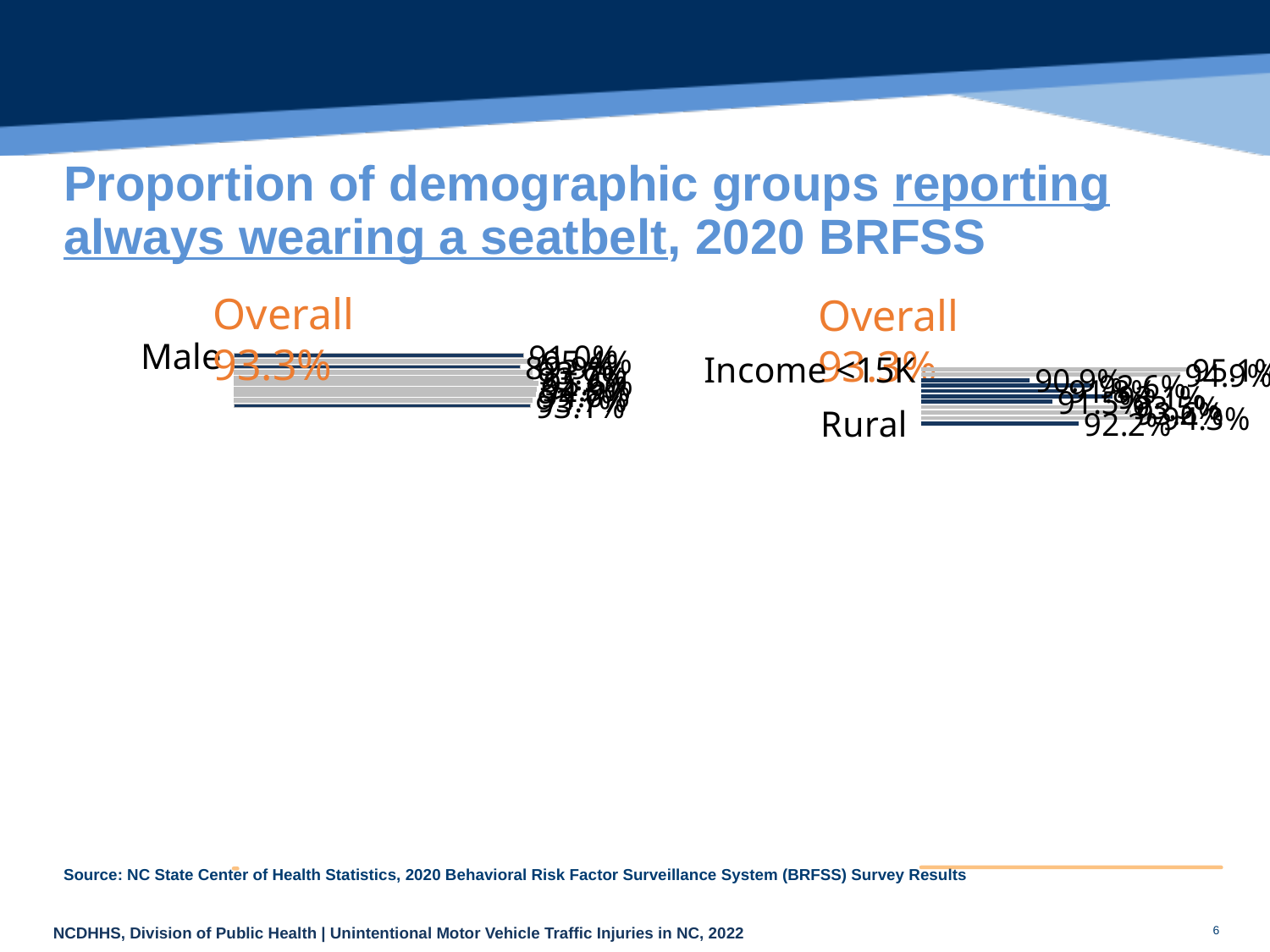
In the right chart, what is the value labelled for Rural? 92.2% What colour is the 'Overall' label text on the charts? orange In the right chart, which is larger, the Overall value or the Rural value? Overall In the right chart, what is the difference between the Overall value and the Rural value? 1.1% How many charts are shown on the slide? 2 What kind of chart is the right chart? bar chart In the left chart, what is the Overall value shown? 93.3% In the right chart, what is the Overall value shown? 93.3% What kind of chart is the left chart? bar chart